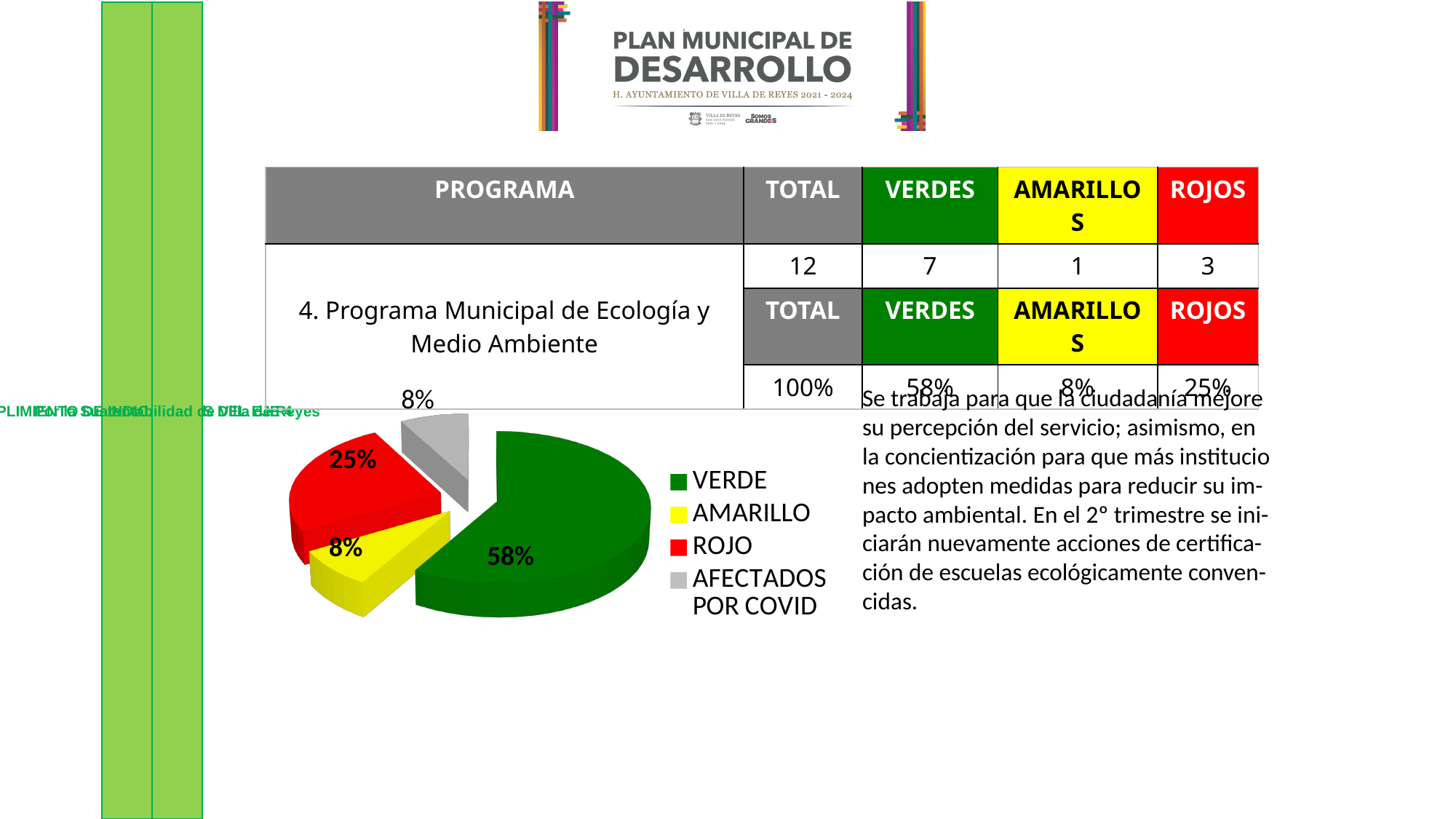
What share of the pie does ROJO represent? 25% What colour is the slice labelled AFECTADOS POR COVID? grey What is the difference in percentage points between the VERDE slice and the ROJO slice? 33 What share of the pie does AFECTADOS POR COVID represent? 8% How many slices does the pie chart have? 4 What share of the pie does AMARILLO represent? 8% Which slice of the pie is the largest? VERDE What kind of chart is shown on the slide? pie chart What share of the pie does VERDE represent? 58% What is the difference in percentage points between the ROJO slice and the AFECTADOS POR COVID slice? 17 Which is larger, the ROJO slice or the AMARILLO slice? ROJO How many entries does the legend of the pie chart list? 4